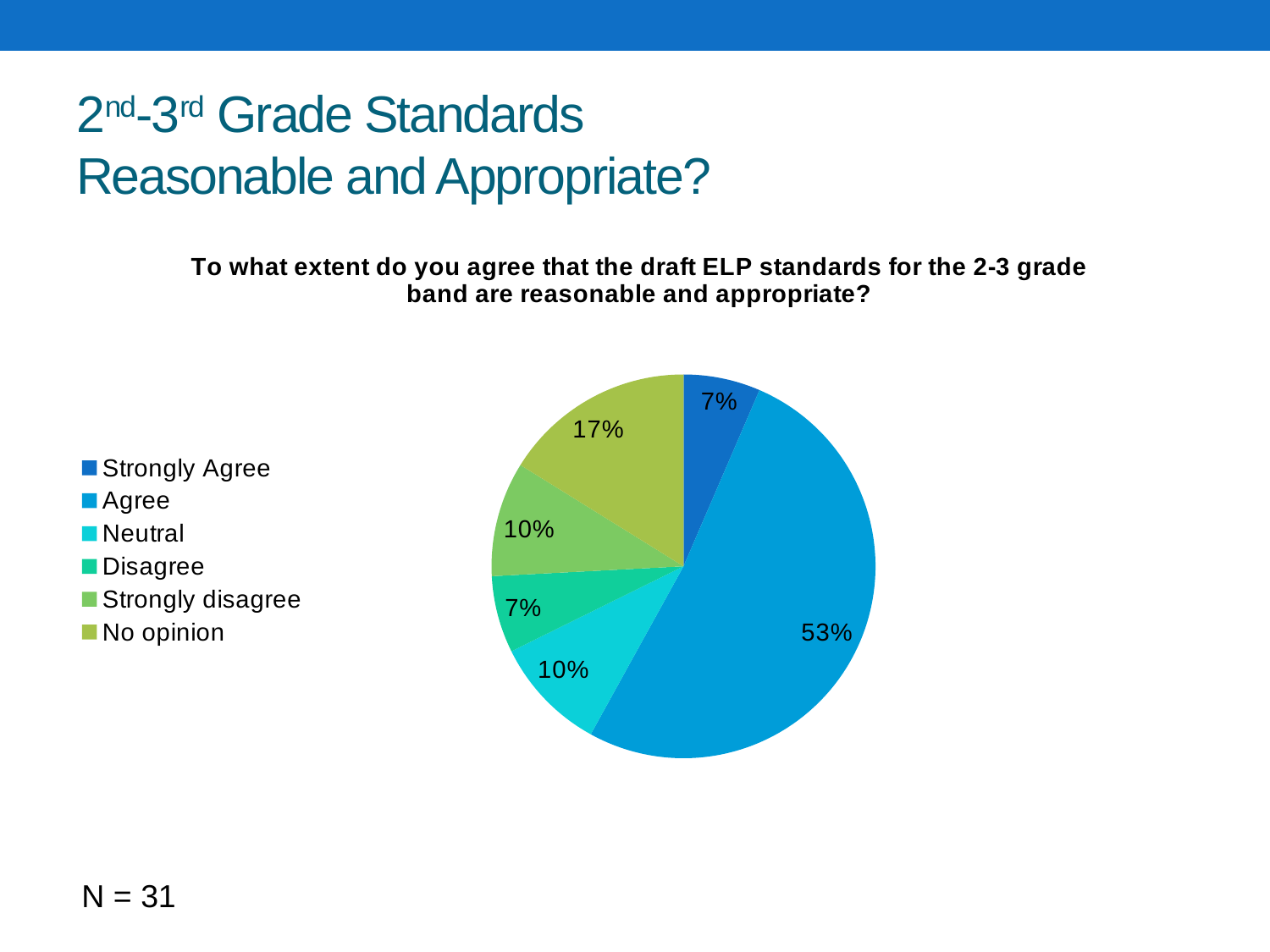
How many response categories does the legend list? 6 What share of the pie is labelled No opinion? 17% What percentage of respondents chose Strongly Agree? 7% What kind of chart is shown on the slide? Pie chart What percentage of respondents chose Neutral? 10% What is the combined percentage for Strongly Agree and Agree? 60% Which response category has the largest slice of the pie? Agree What is the sample size (N) shown on the slide? 31 What percentage of respondents chose Agree? 53% What is the title of the chart above the pie? To what extent do you agree that the draft ELP standards for the 2-3 grade band are reasonable and appropriate? What is the difference in percentage points between Agree and No opinion? 36 Which is larger, the share for No opinion or the share for Strongly disagree? No opinion